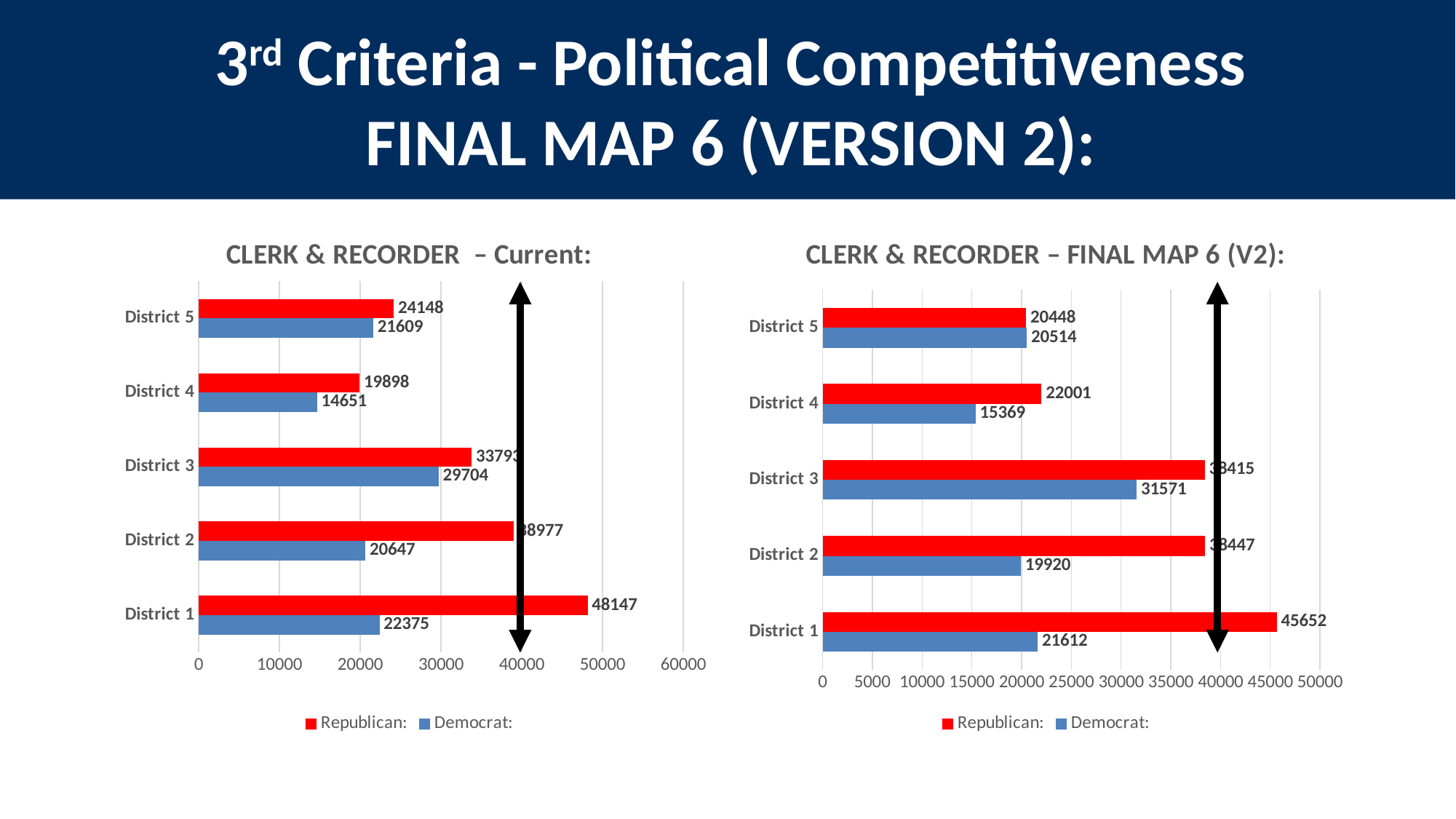
In the CLERK & RECORDER – Current chart, which district has the lowest Democrat value? District 4 In the CLERK & RECORDER – Current chart, which district has the highest Republican value? District 1 In the CLERK & RECORDER – Current chart, what is the Democrat value for District 4? 14651 In the CLERK & RECORDER – Current chart, what is the Republican value for District 1? 48147 In the CLERK & RECORDER – FINAL MAP 6 (V2) chart, what is the Democrat value for District 3? 31571 How many districts are shown in the CLERK & RECORDER – Current chart? 5 In the CLERK & RECORDER – FINAL MAP 6 (V2) chart, which is larger for District 5, the Republican value or the Democrat value? Democrat In the CLERK & RECORDER – FINAL MAP 6 (V2) chart, is the Republican value for District 1 greater or less than 40000? greater In the CLERK & RECORDER – FINAL MAP 6 (V2) chart, what is the difference between the Republican and Democrat values for District 1? 24040 In the CLERK & RECORDER – FINAL MAP 6 (V2) chart, what is the Republican value for District 4? 22001 In the CLERK & RECORDER – Current chart, what is the difference between the Republican and Democrat values for District 5? 2539 What type of chart is the CLERK & RECORDER – FINAL MAP 6 (V2) chart? Bar chart